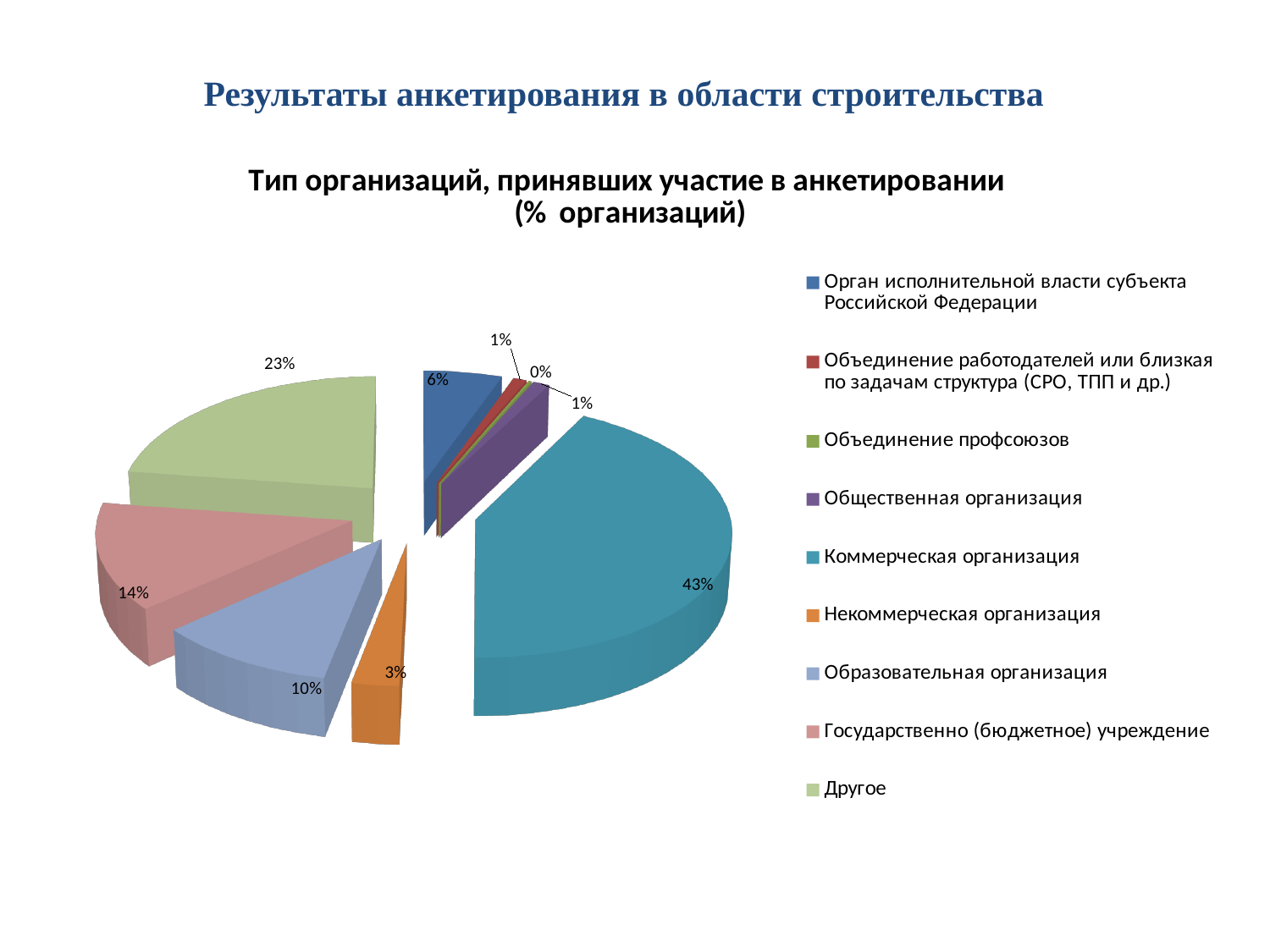
By how many percentage points does Коммерческая организация exceed Другое? 20 percentage points What value is labelled for Государственно (бюджетное) учреждение? 14% What percentage is shown for Некоммерческая организация? 3% What value is labelled for Орган исполнительной власти субъекта Российской Федерации? 6% What percentage is shown for Образовательная организация? 10% How many organisation types are listed in the legend? 9 What share of the pie does Коммерческая организация hold? 43% Which organisation type has the smallest share of the pie? Объединение профсоюзов Which organisation type has the largest share of the pie? Коммерческая организация What kind of chart is shown on the slide? Pie chart Which is larger: the share for Другое or for Государственно (бюджетное) учреждение? Другое What percentage is shown for Другое? 23%